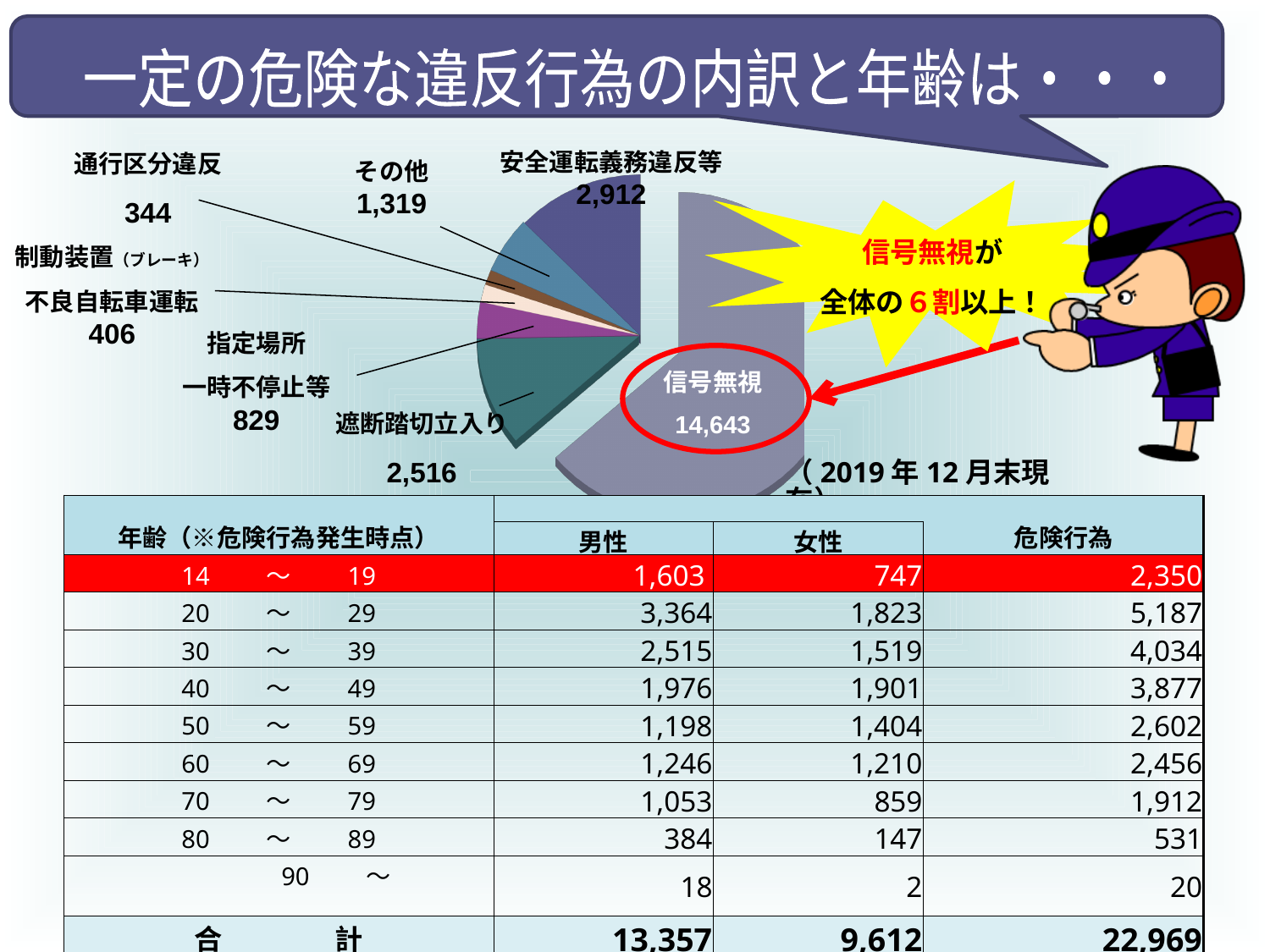
What is the value for 安全運転義務違反等 in the pie chart? 2,912 What is the value for 信号無視 in the pie chart? 14,643 What is the value for 遮断踏切立入り in the pie chart? 2,516 How many categories (slices) does the pie chart show? 7 Which is larger in the pie chart, その他 or 指定場所一時不停止等? その他 What is the title of the slide containing the pie chart? 一定の危険な違反行為の内訳と年齢は・・・ Which category has the smallest slice in the pie chart? 通行区分違反 What kind of chart is shown on the slide? pie chart Which category has the largest slice in the pie chart? 信号無視 What is the total of all the values shown in the pie chart? 22,969 What is the value for 通行区分違反 in the pie chart? 344 What is the difference between the values for 安全運転義務違反等 and 遮断踏切立入り in the pie chart? 396